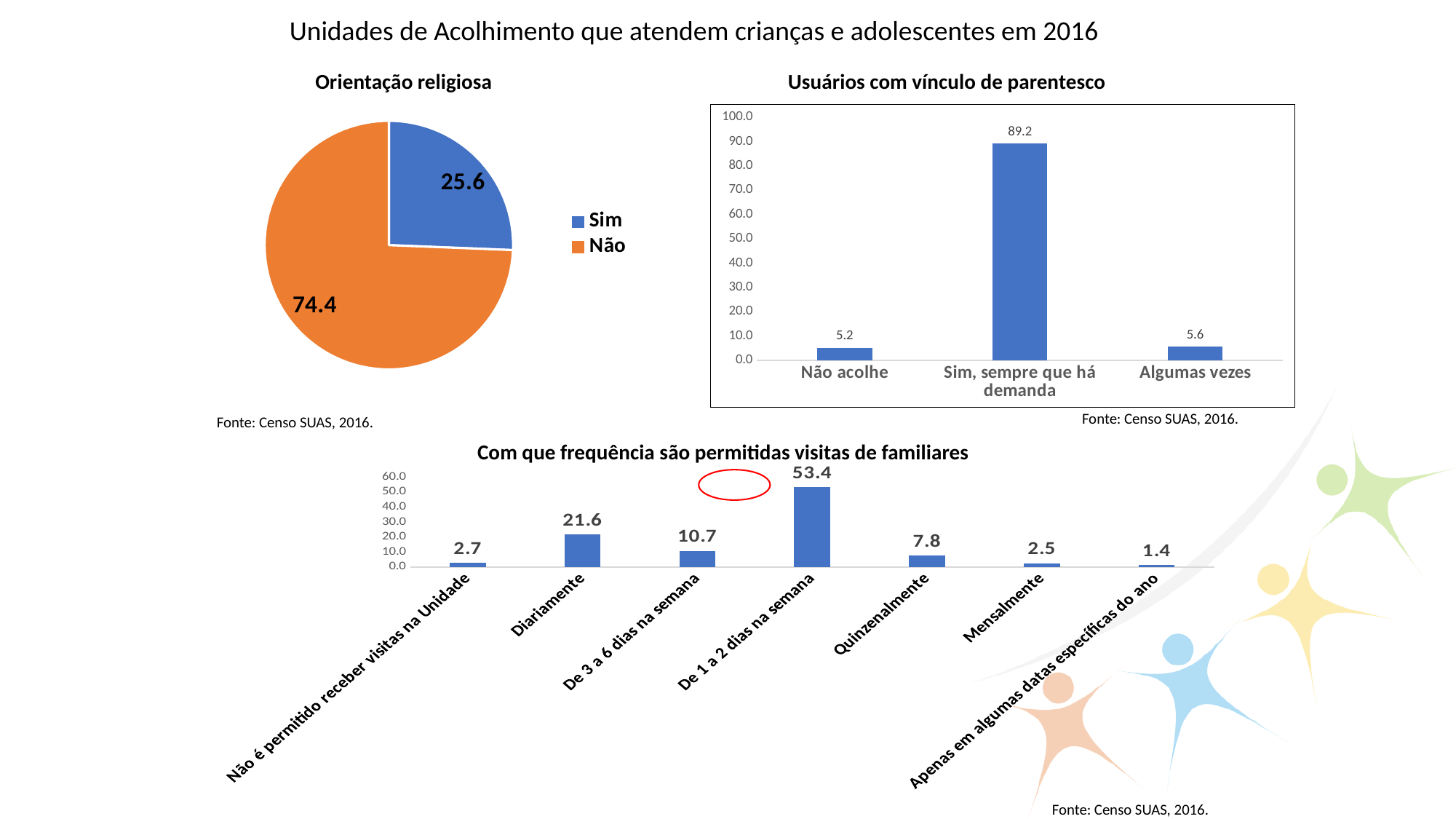
In the 'Usuários com vínculo de parentesco' chart, what is the value for 'Sim, sempre que há demanda'? 89.2 In the 'Orientação religiosa' chart, how many entries does the legend list? 2 In the 'Orientação religiosa' chart, what is the value for 'Não'? 74.4 In the 'Com que frequência são permitidas visitas de familiares' chart, which category has the highest value? De 1 a 2 dias na semana In the 'Com que frequência são permitidas visitas de familiares' chart, which is larger: 'Quinzenalmente' or 'Mensalmente'? Quinzenalmente In the 'Usuários com vínculo de parentesco' chart, how many categories are shown? 3 In the 'Com que frequência são permitidas visitas de familiares' chart, what is the value for 'Diariamente'? 21.6 What kind of chart is the 'Orientação religiosa' chart? Pie chart In the 'Orientação religiosa' chart, what is the value for 'Sim'? 25.6 In the 'Com que frequência são permitidas visitas de familiares' chart, how many categories are shown? 7 In the 'Usuários com vínculo de parentesco' chart, what is the difference between 'Sim, sempre que há demanda' and 'Algumas vezes'? 83.6 In the 'Usuários com vínculo de parentesco' chart, which category has the lowest value? Não acolhe